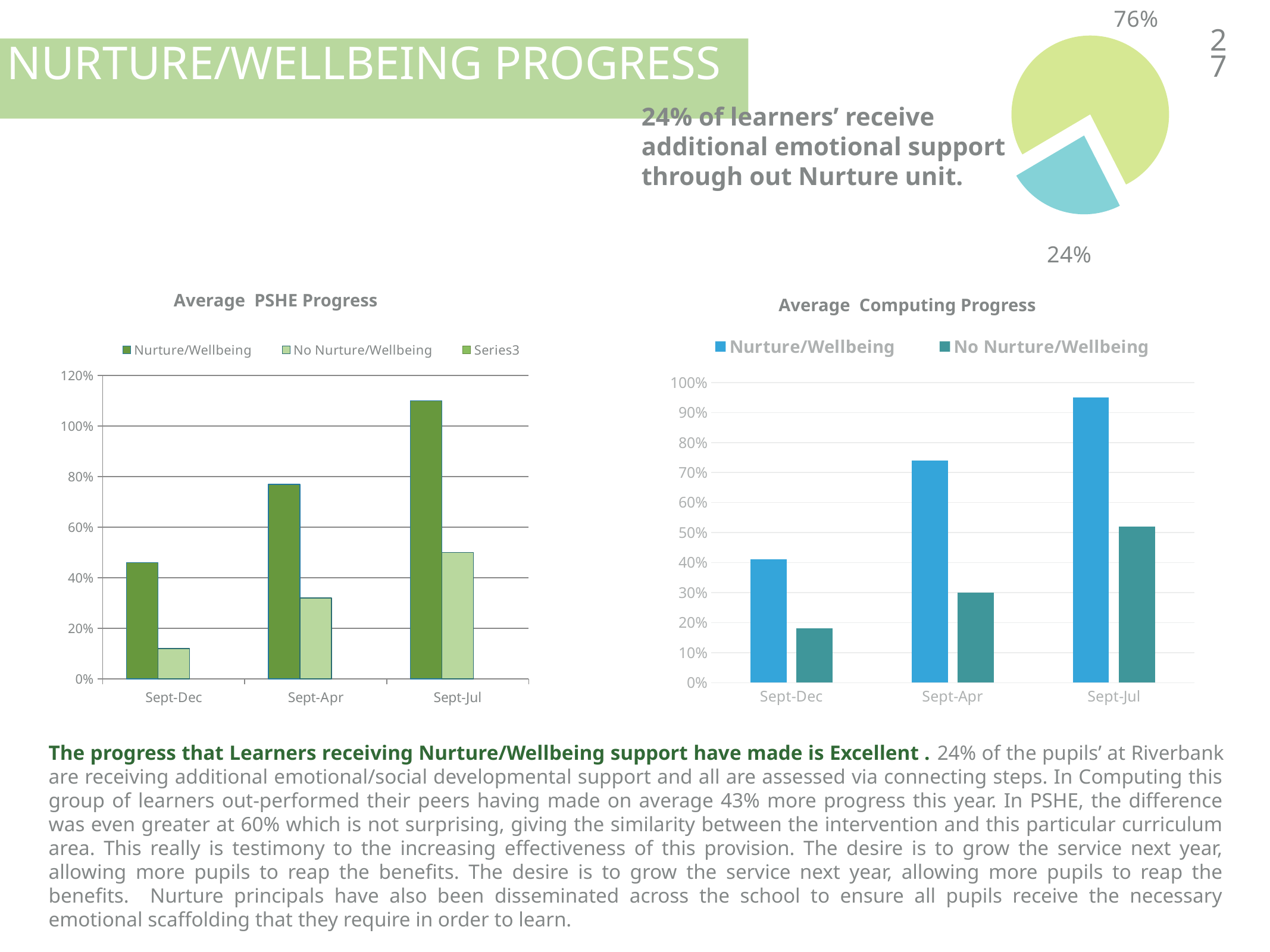
How many categories are shown on the x axis of the Average PSHE Progress chart? 3 In the Average PSHE Progress chart, is the No Nurture/Wellbeing value for Sept-Dec greater or less than 20%? less In the Average Computing Progress chart, which category has the lowest No Nurture/Wellbeing value? Sept-Dec In the pie chart at the top right, what share does the larger slice represent? 76% How many series does the legend of the Average Computing Progress chart list? 2 In the Average Computing Progress chart, which category has the highest Nurture/Wellbeing value? Sept-Jul How many series does the legend of the Average PSHE Progress chart list? 3 In the Average Computing Progress chart, is the Nurture/Wellbeing value for Sept-Jul greater or less than 90%? greater In the pie chart at the top right, what share does the smaller slice represent? 24% What kind of chart is the Average Computing Progress chart? Bar chart In the Average PSHE Progress chart, do the Nurture/Wellbeing values rise or fall from Sept-Dec to Sept-Jul? rise In the Average PSHE Progress chart, is the Nurture/Wellbeing value for Sept-Jul greater or less than 100%? greater